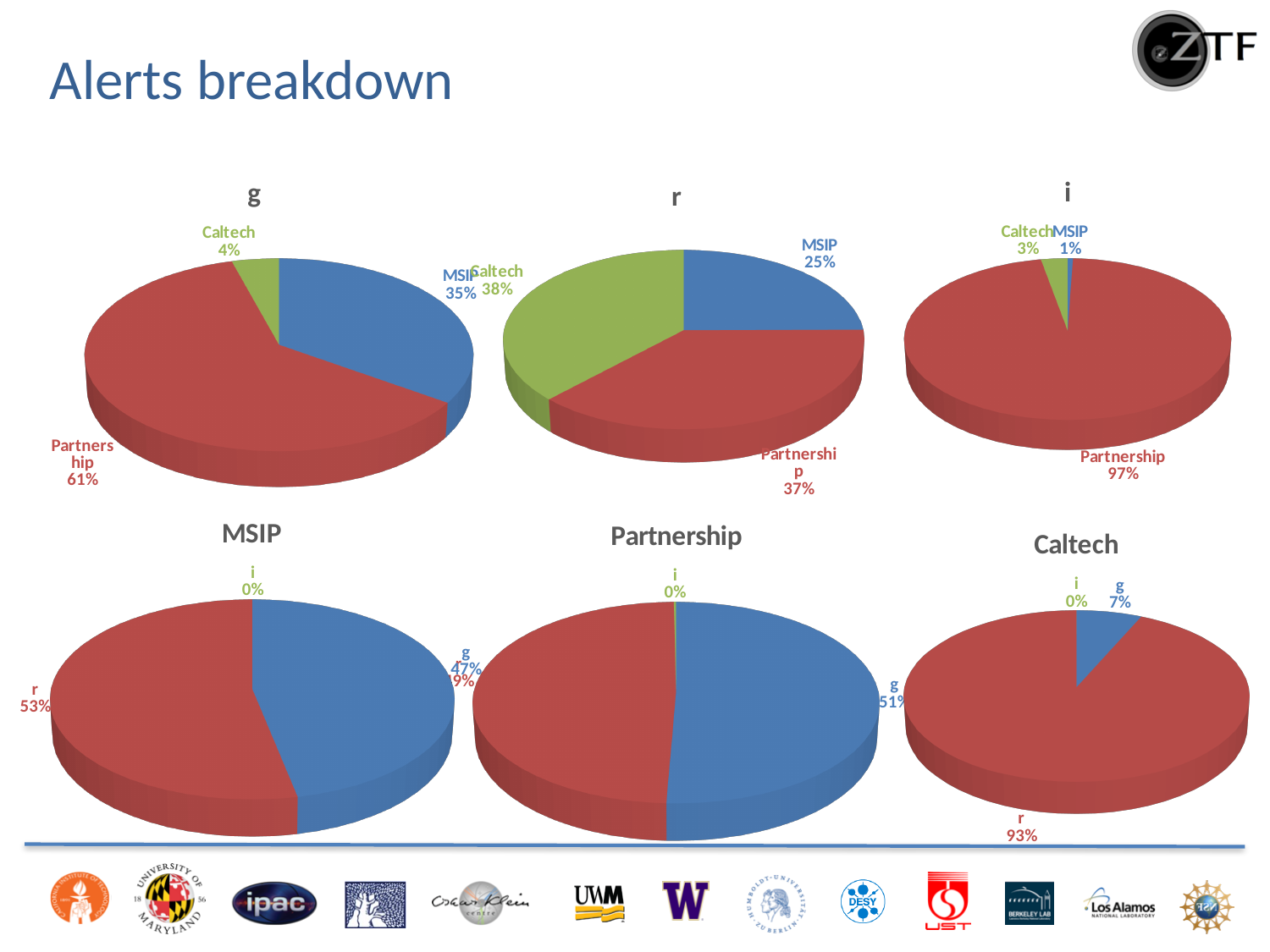
In the pie chart titled "Partnership", what percentage is labelled for g? 51% In the pie chart titled "i", which category has the largest slice? Partnership How many pie charts are shown on the slide? 6 In the pie chart titled "Caltech", what percentage is labelled for r? 93% In the pie chart titled "MSIP", what percentage is labelled for r? 53% In the pie chart titled "Caltech", which is larger, the g slice or the r slice? r In the pie chart titled "g", what percentage is labelled for Caltech? 4% In the pie chart titled "r", what percentage is labelled for MSIP? 25% In the pie chart titled "r", which category has the smallest slice? MSIP In the pie chart titled "MSIP", what is the difference between the r and g percentages? 6% In the pie chart titled "i", what share of alerts is Partnership? 97% In the pie chart titled "g", what share of alerts is Partnership? 61%